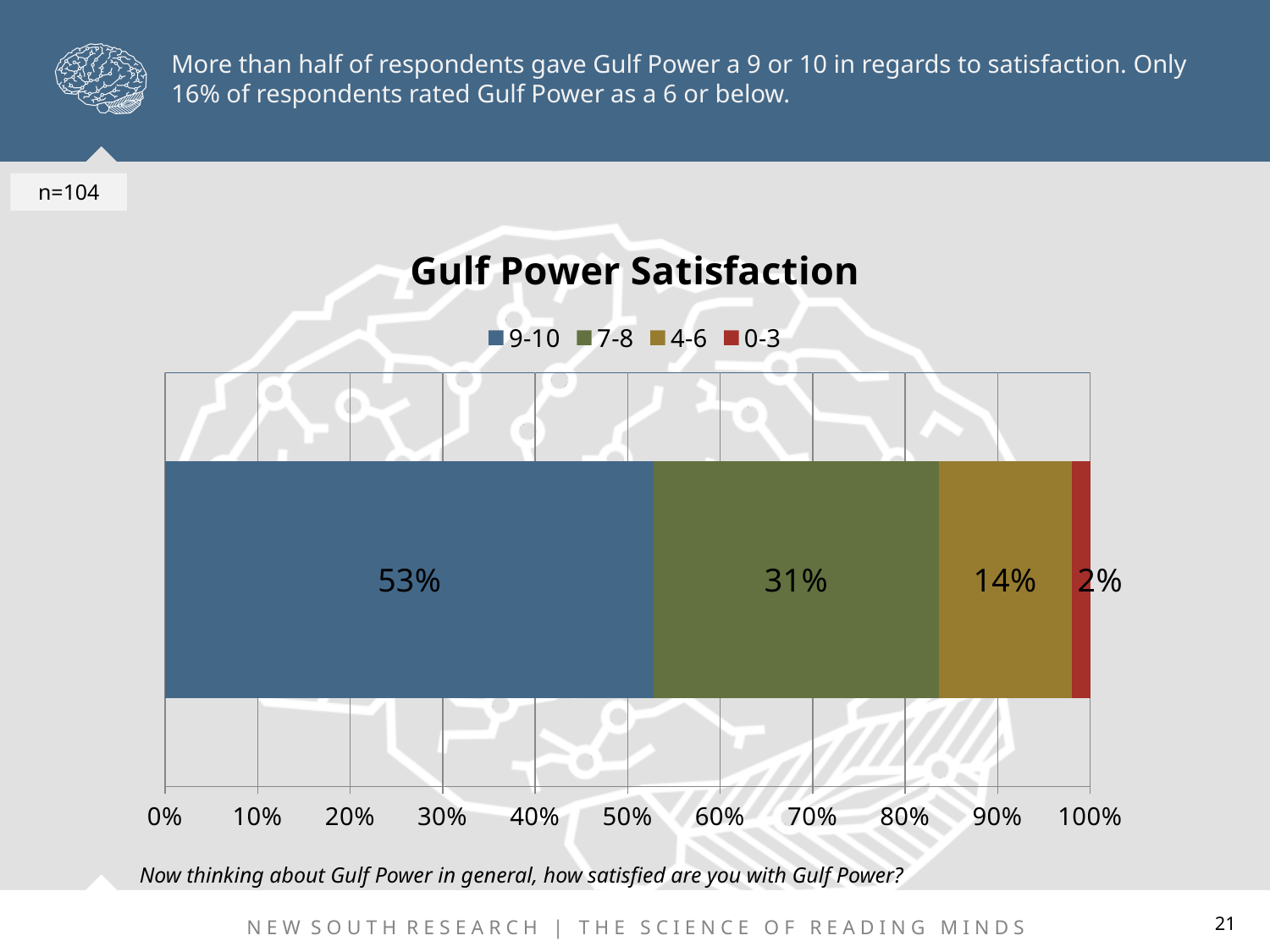
What is the title of the chart? Gulf Power Satisfaction What is the total of the 4-6 and 0-3 segments combined? 16% What percentage of respondents rated Gulf Power 7-8? 31% Which rating group has the largest share of respondents? 9-10 Which rating group has the smallest share of respondents? 0-3 What percentage of respondents rated Gulf Power 0-3? 2% What percentage of respondents rated Gulf Power 9-10? 53% What kind of chart is shown on the slide? Stacked bar chart What is the difference in percentage points between the 9-10 group and the 7-8 group? 22 percentage points How many series does the legend list? 4 What percentage of respondents rated Gulf Power 4-6? 14% Which is larger, the share for 7-8 or the share for 4-6? 7-8